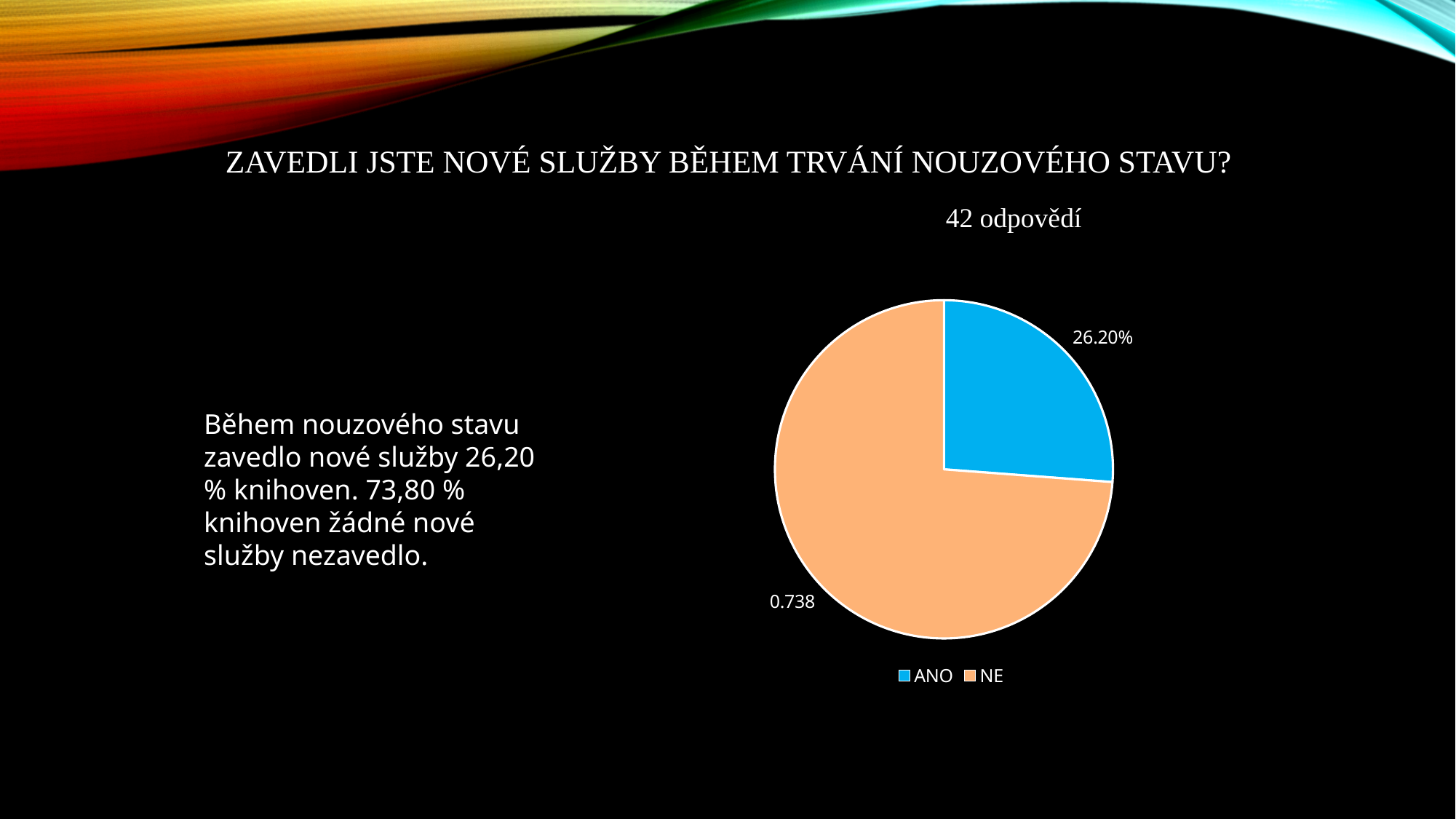
Which category has the largest slice in the pie chart? NE What value is labelled on the ANO slice of the pie chart? 26.20% What colour is the ANO slice in the pie chart? blue What share of the pie does the ANO slice represent, as labelled on the chart? 26.20% Which slice is larger in the pie chart, ANO or NE? NE How many slices does the pie chart have? 2 What kind of chart is shown on the slide? pie chart What value is labelled on the NE slice of the pie chart? 0.738 How many entries does the legend of the pie chart list? 2 What text appears as the title above the pie chart? 42 odpovědí Which category has the smallest slice in the pie chart? ANO